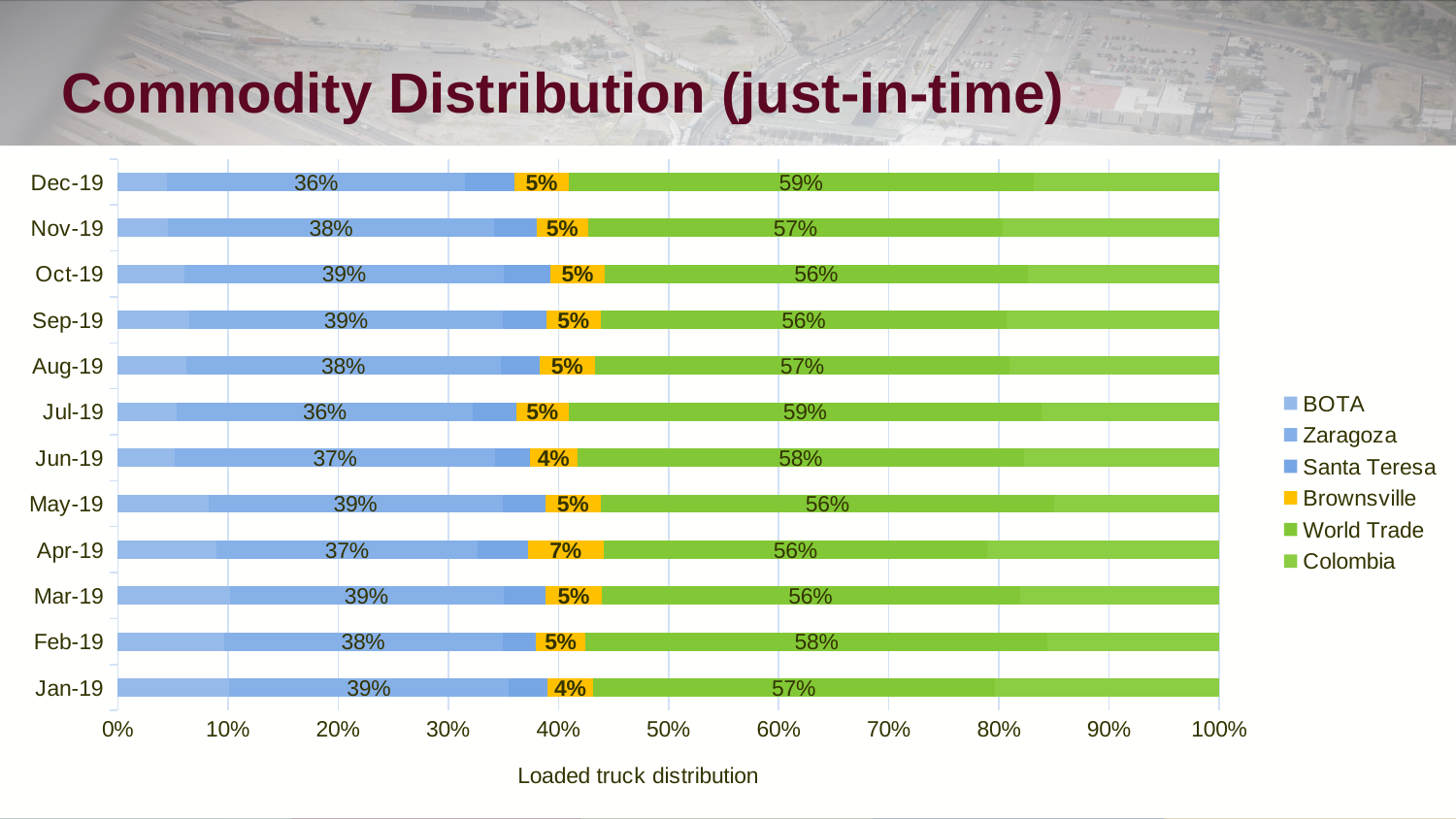
Which is larger: the orange segment value for Apr-19 or for Mar-19? Apr-19 What is the difference between the green segment value and the blue segment value for Dec-19? 23% What value is printed on the orange segment for Jun-19? 4% Which is larger: the blue segment value for Oct-19 or for Jul-19? Oct-19 What is the axis title shown below the chart? Loaded truck distribution How many months are shown on the chart? 12 What kind of chart is shown on the slide? Stacked bar chart How many series does the legend list? 6 Which month has the highest value printed on its orange segment? Apr-19 What value is printed on the blue segment for Jan-19? 39% What value is printed on the green segment for Dec-19? 59% What value is printed on the orange segment for Apr-19? 7%